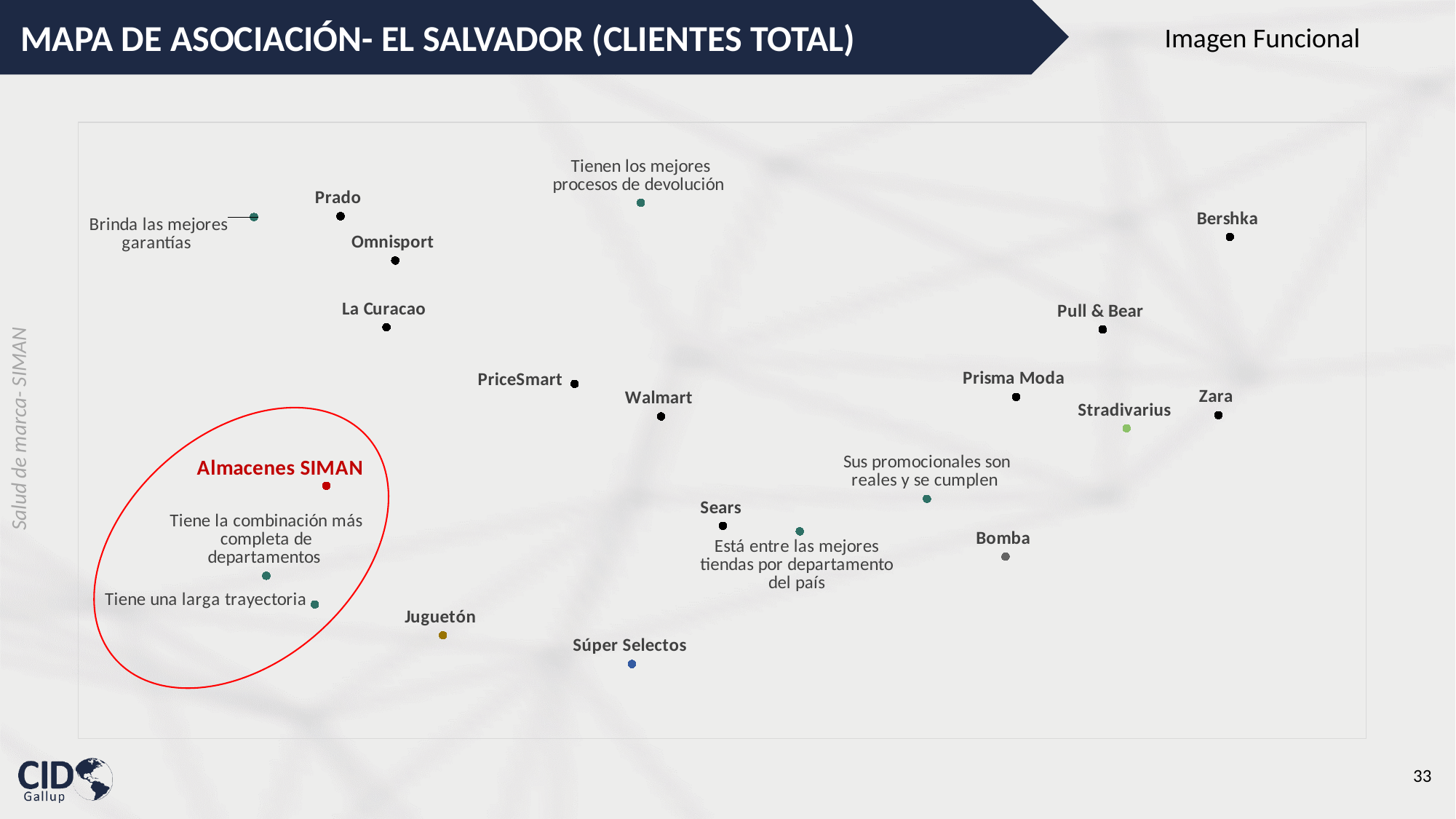
Which brand is plotted closest to Stradivarius? Zara What is the title of the chart on the slide? MAPA DE ASOCIACIÓN- EL SALVADOR (CLIENTES TOTAL) Which brand is plotted closest to the attribute 'Brinda las mejores garantías'? Prado How many brand names are plotted on the association map? 15 Which two attributes are inside the red circle with Almacenes SIMAN? Tiene la combinación más completa de departamentos; Tiene una larga trayectoria How many attribute statements (non-brand labels) are plotted on the map? 6 Which brand is highlighted in red and enclosed by the red circle? Almacenes SIMAN What kind of chart is shown on the slide? Scatter plot (association map) Which brand is plotted highest on the map? Prado Which brand is plotted closest to the attribute 'Está entre las mejores tiendas por departamento del país'? Sears Which brand is plotted lowest on the map? Súper Selectos